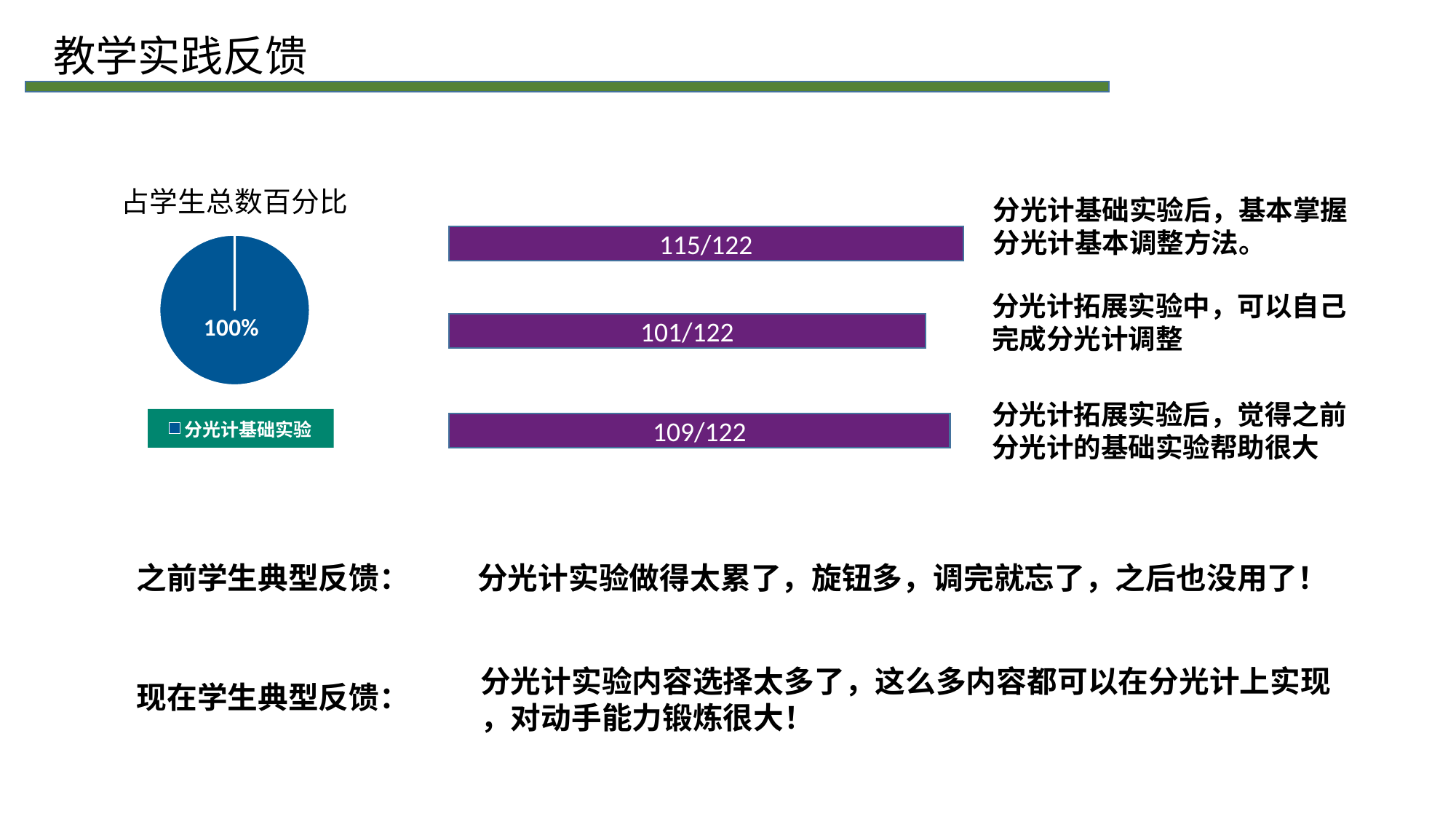
What is the legend entry shown under the pie chart titled 占学生总数百分比? 分光计基础实验 How many entries does the legend of the pie chart titled 占学生总数百分比 list? 1 In the pie chart titled 占学生总数百分比, what share does the slice 分光计基础实验 have? 100% What is the title of the pie chart on the left of the slide? 占学生总数百分比 What kind of chart is the chart titled 占学生总数百分比 on the left of the slide? pie chart